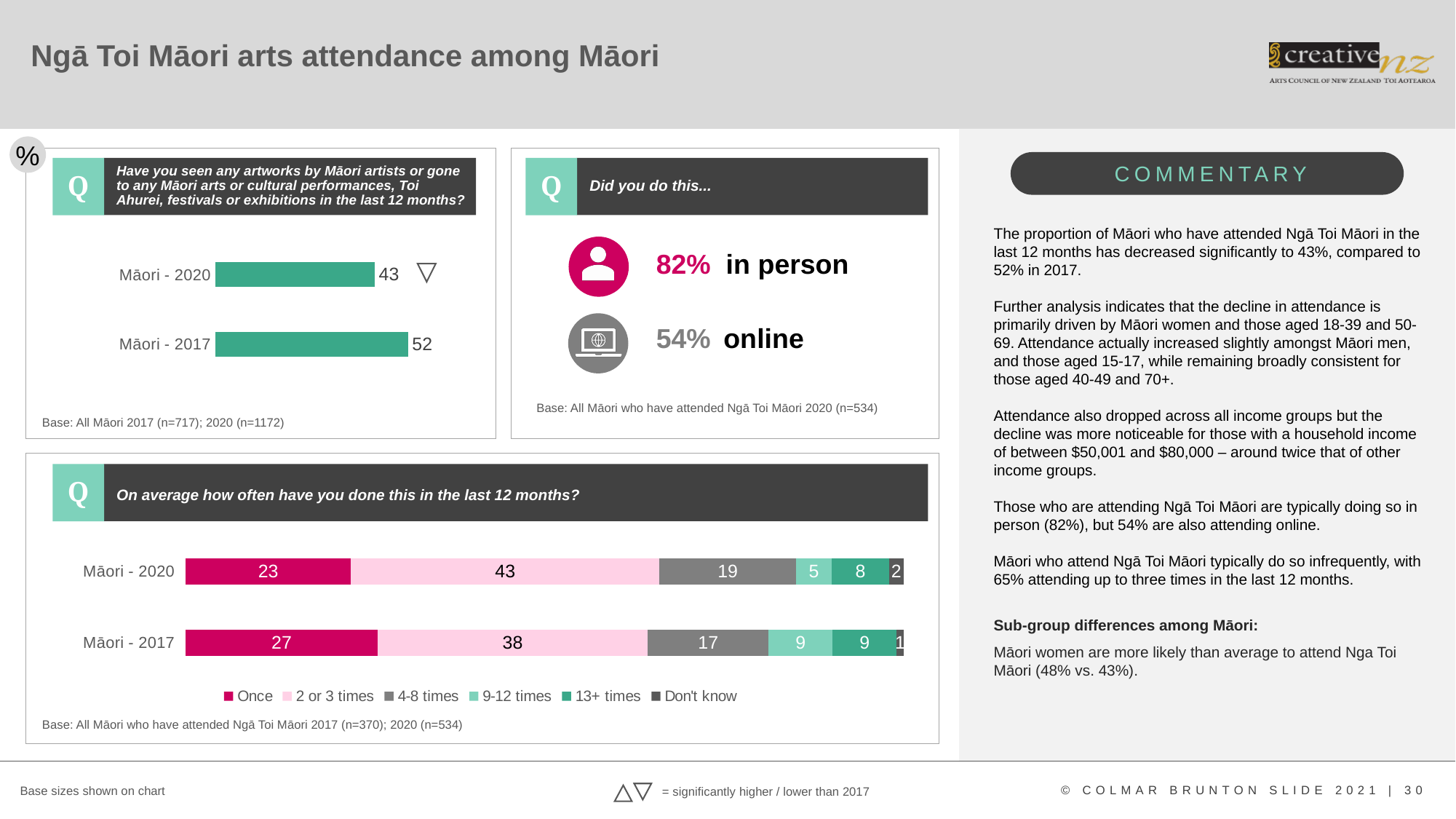
In the bottom chart on how often this was done in the last 12 months, what is the value for '2 or 3 times' for Māori - 2020? 43 In the top-left chart about seeing artworks by Māori artists, which is larger, Māori - 2020 or Māori - 2017? Māori - 2017 In the bottom chart on how often this was done in the last 12 months, what is the difference between the '4-8 times' values for Māori - 2020 and Māori - 2017? 2 How many categories are shown in the top-left chart about seeing artworks by Māori artists? 2 In the top-left chart about seeing artworks by Māori artists, what is the value for Māori - 2020? 43 In the bottom chart on how often this was done in the last 12 months, which frequency category has the highest value for Māori - 2020? 2 or 3 times What kind of chart is the top-left chart about seeing artworks by Māori artists? Bar chart In the bottom chart on how often this was done in the last 12 months, what is the value for 'Once' for Māori - 2017? 27 In the top-left chart about seeing artworks by Māori artists, what is the value for Māori - 2017? 52 In the bottom chart on how often this was done in the last 12 months, what is the total of the Māori - 2020 stacked bar? 100 How many series does the legend of the bottom chart on how often this was done in the last 12 months list? 6 In the top-left chart about seeing artworks by Māori artists, what is the difference between the Māori - 2017 and Māori - 2020 values? 9